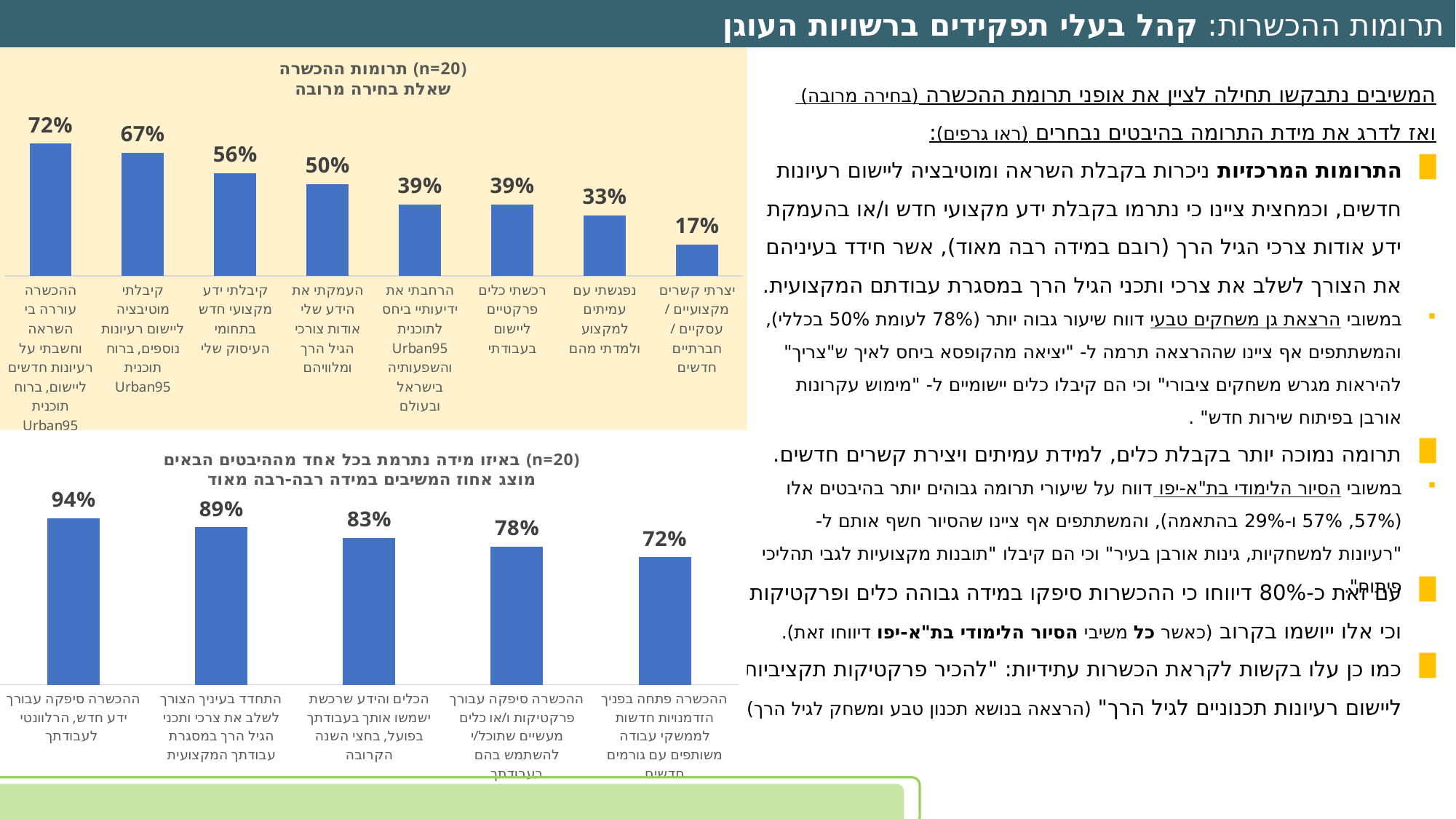
In the top chart (תרומות ההכשרה), how many categories are plotted? 8 In the top chart (תרומות ההכשרה), what percentage is shown for 'קיבלתי ידע מקצועי חדש בתחומי העיסוק שלי'? 56% In the top chart (תרומות ההכשרה), what is the difference between the highest value (72%) and the lowest value (17%)? 55% In the bottom chart (באיזו מידה נתרמת), what is the difference between 'התחדד בעיניך הצורך לשלב את צרכי ותכני הגיל הרך' (89%) and 'ההכשרה סיפקה עבורך פרקטיקות ו/או כלים מעשיים' (78%)? 11% In the top chart (תרומות ההכשרה), what value is shown for 'נפגשתי עם עמיתים למקצוע ולמדתי מהם'? 33% In the top chart (תרומות ההכשרה), which category has the highest value? ההכשרה עוררה בי השראה וחשבתי על רעיונות חדשים ליישום, ברוח תוכנית Urban95 In the bottom chart (באיזו מידה נתרמת), which category has the lowest value? ההכשרה פתחה בפניך הזדמנויות חדשות לממשקי עבודה משותפים עם גורמים חדשים In the bottom chart (באיזו מידה נתרמת), what percentage is shown for 'ההכשרה סיפקה עבורך ידע חדש, הרלוונטי לעבודתך'? 94% What type of chart is the bottom chart (באיזו מידה נתרמת)? Bar chart In the top chart (תרומות ההכשרה), which category has the lowest value? יצרתי קשרים מקצועיים / עסקיים / חברתיים חדשים In the bottom chart (באיזו מידה נתרמת), which is larger: the value for 'הכלים והידע שרכשת ישמשו אותך בעבודתך בפועל' or the value for 'ההכשרה פתחה בפניך הזדמנויות חדשות'? הכלים והידע שרכשת ישמשו אותך בעבודתך בפועל In the bottom chart (באיזו מידה נתרמת), how many categories are plotted? 5